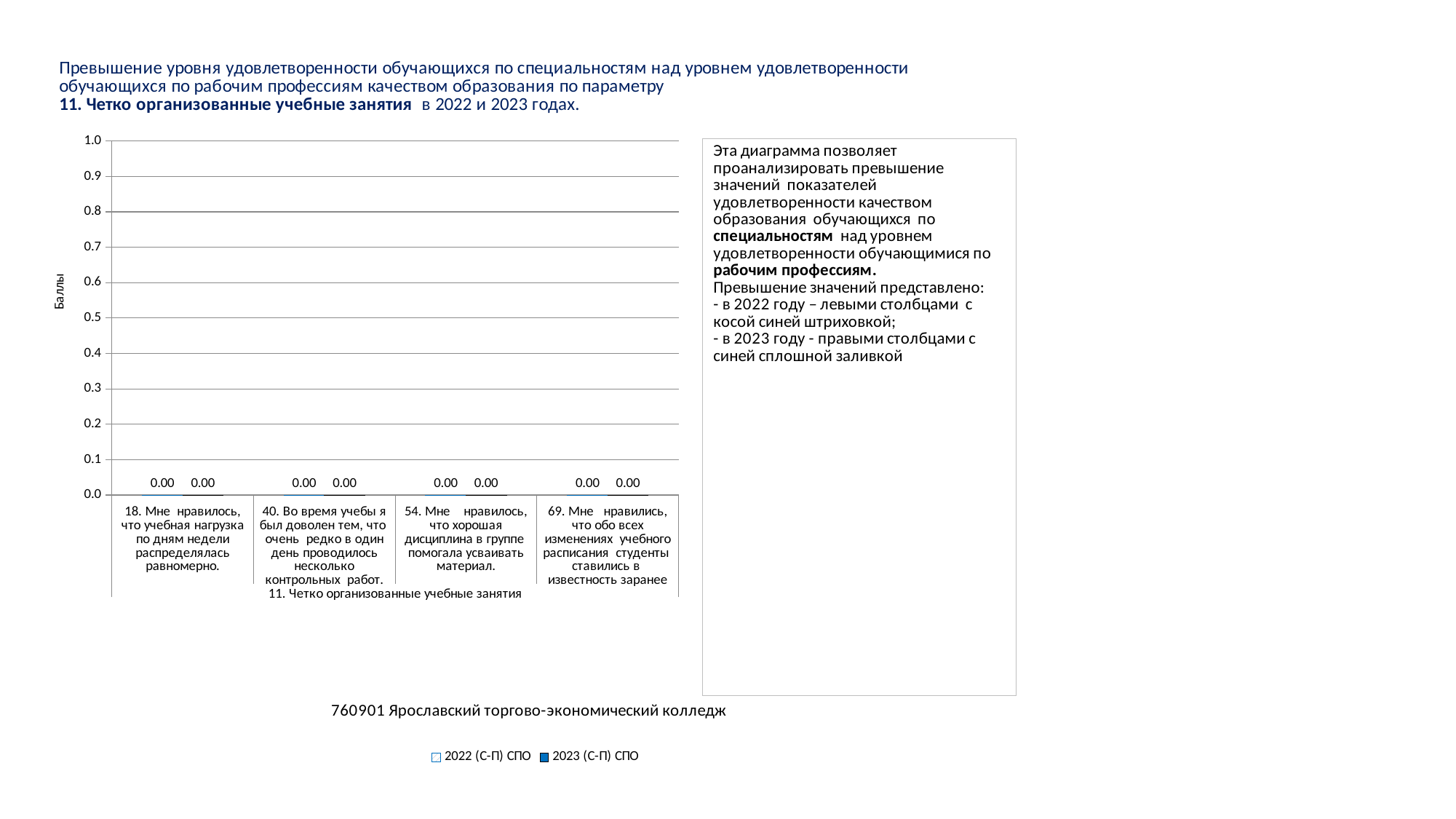
What kind of chart is shown on the slide? bar chart How many series does the chart legend list? 2 What is the value for the 2023 (С-П) СПО series for category 40 ("Во время учебы я был доволен тем, что очень редко в один день проводилось несколько контрольных работ")? 0.00 What is the value for the 2023 (С-П) СПО series for category 54 ("Мне нравилось, что хорошая дисциплина в группе помогала усваивать материал")? 0.00 What is the label of the y axis of the chart? Баллы Is the value for the 2023 (С-П) СПО series for category 69 greater or less than 0.5? less What are the two series names listed in the chart legend? 2022 (С-П) СПО and 2023 (С-П) СПО What is the difference between the 2022 (С-П) СПО and 2023 (С-П) СПО values for category 18? 0.00 How many categories are shown on the x axis of the chart? 4 What is the value for the 2022 (С-П) СПО series for category 69 ("Мне нравились, что обо всех изменениях учебного расписания студенты ставились в известность заранее")? 0.00 What is the value for the 2022 (С-П) СПО series for category 18 ("Мне нравилось, что учебная нагрузка по дням недели распределялась равномерно")? 0.00